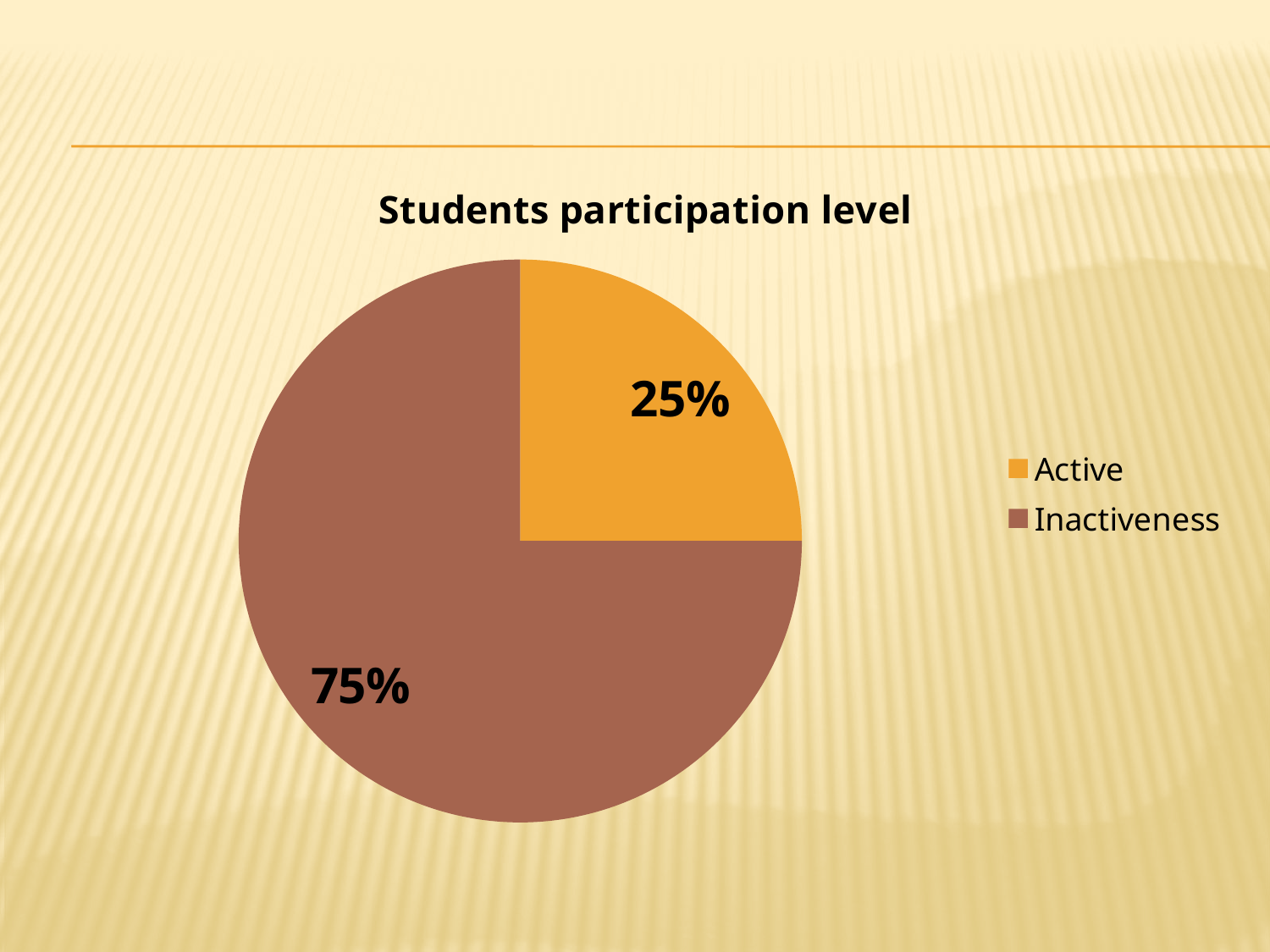
Which is larger, the Active slice or the Inactiveness slice? Inactiveness What is the difference in percentage points between the Inactiveness slice and the Active slice? 50 What percentage of the pie is labelled Active? 25% Which slice of the pie is the smallest? Active What colour is the Active slice in the pie chart? orange How many slices does the pie chart have? 2 What kind of chart is shown on the slide? pie chart What share of the pie does the Active slice represent? 25% What percentage of the pie is labelled Inactiveness? 75% How many entries does the legend list? 2 Which slice of the pie is the largest? Inactiveness What is the title of the chart? Students participation level